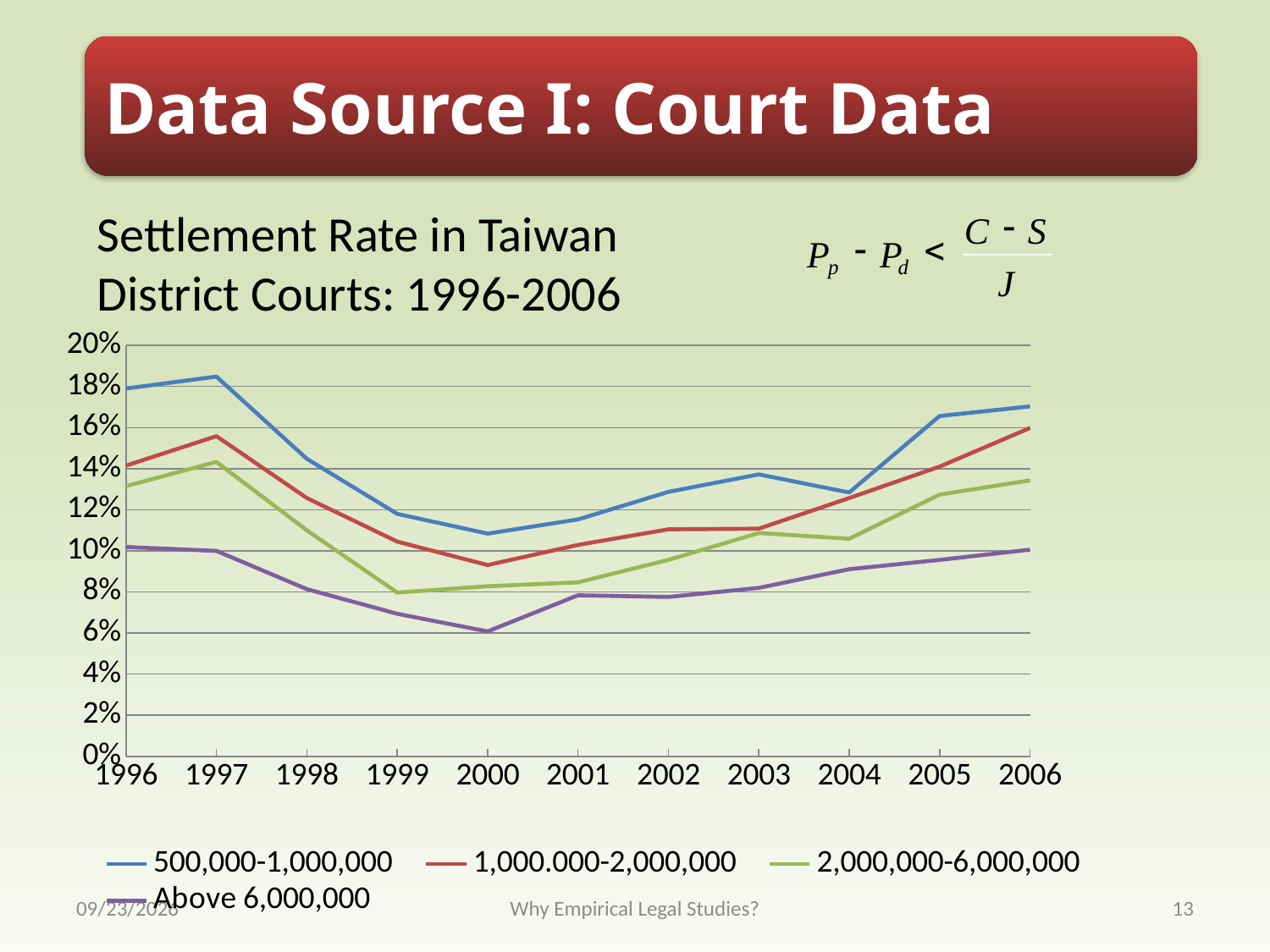
What kind of chart is shown on the slide? line chart What is the title of the chart? Settlement Rate in Taiwan District Courts: 1996-2006 How many years are shown on the x axis? 11 Is the value for 2,000,000-6,000,000 in 1999 greater or less than 10%? less Is the value for Above 6,000,000 in 2000 greater or less than 8%? less In which year is the settlement rate for 500,000-1,000,000 highest? 1997 In 2006, which is larger: the value for 500,000-1,000,000 or the value for Above 6,000,000? 500,000-1,000,000 Is the value for 500,000-1,000,000 in 1997 greater or less than 18%? greater Does the settlement rate for 1,000.000-2,000,000 rise or fall from 1997 to 2000? fall In which year is the settlement rate for 1,000.000-2,000,000 lowest? 2000 How many series does the legend list? 4 In which year is the settlement rate for Above 6,000,000 lowest? 2000